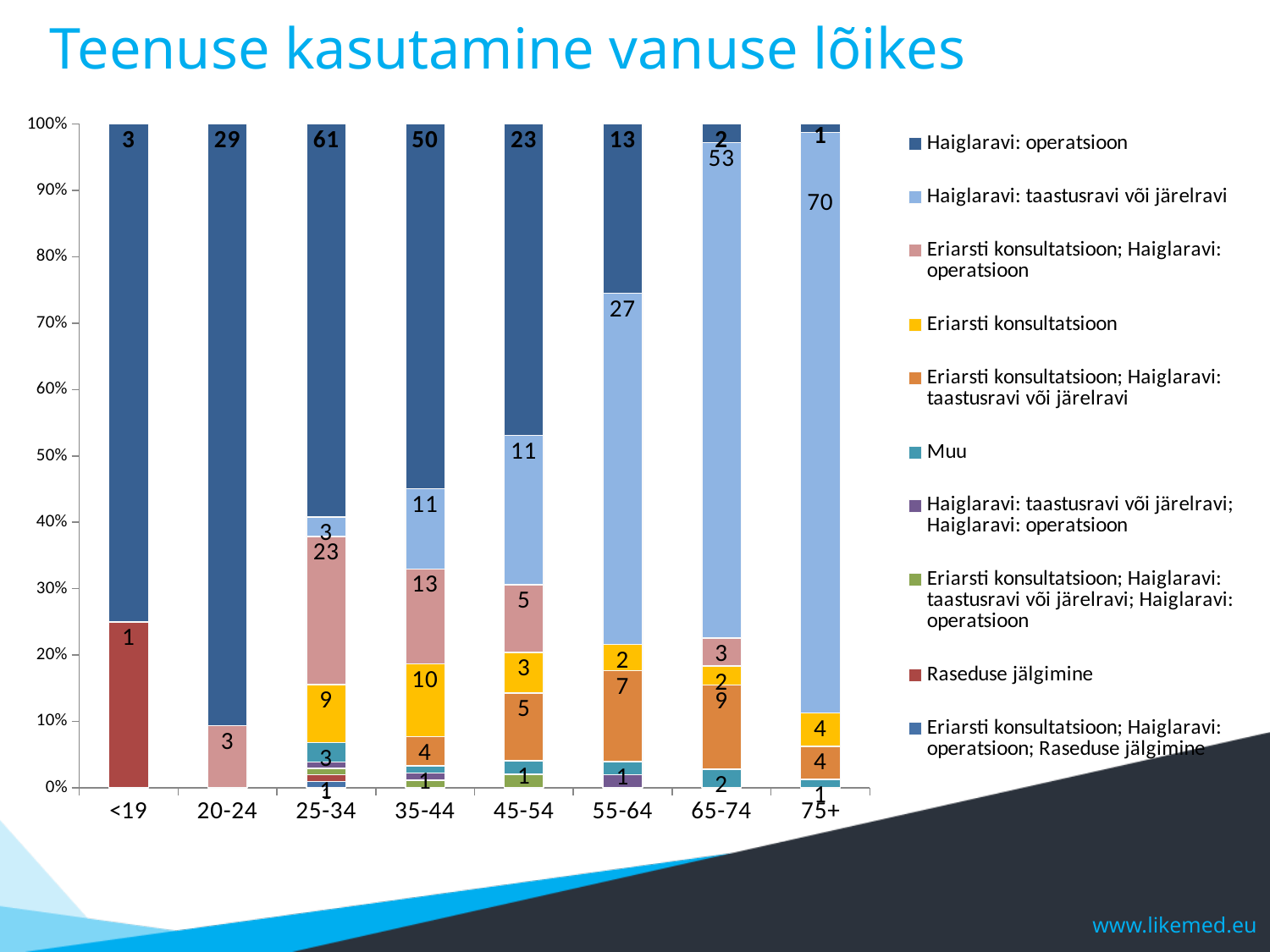
What is the title of the chart? Teenuse kasutamine vanuse lõikes What is the value for Haiglaravi: taastusravi või järelravi in the 75+ age group? 70 What is the value for Haiglaravi: taastusravi või järelravi in the 55-64 age group? 27 What is the difference between the Haiglaravi: operatsioon values for the 25-34 and 35-44 age groups? 11 What is the value for Haiglaravi: operatsioon in the 25-34 age group? 61 Which age group has the highest value for Haiglaravi: operatsioon? 25-34 Which is larger: Haiglaravi: taastusravi või järelravi for 65-74 or for 55-64? 65-74 Which age group has the highest value for Haiglaravi: taastusravi või järelravi? 75+ How many series does the legend list? 10 What is the value for Eriarsti konsultatsioon in the 35-44 age group? 10 How many age groups are shown on the x axis? 8 What kind of chart is shown on the slide? stacked bar chart